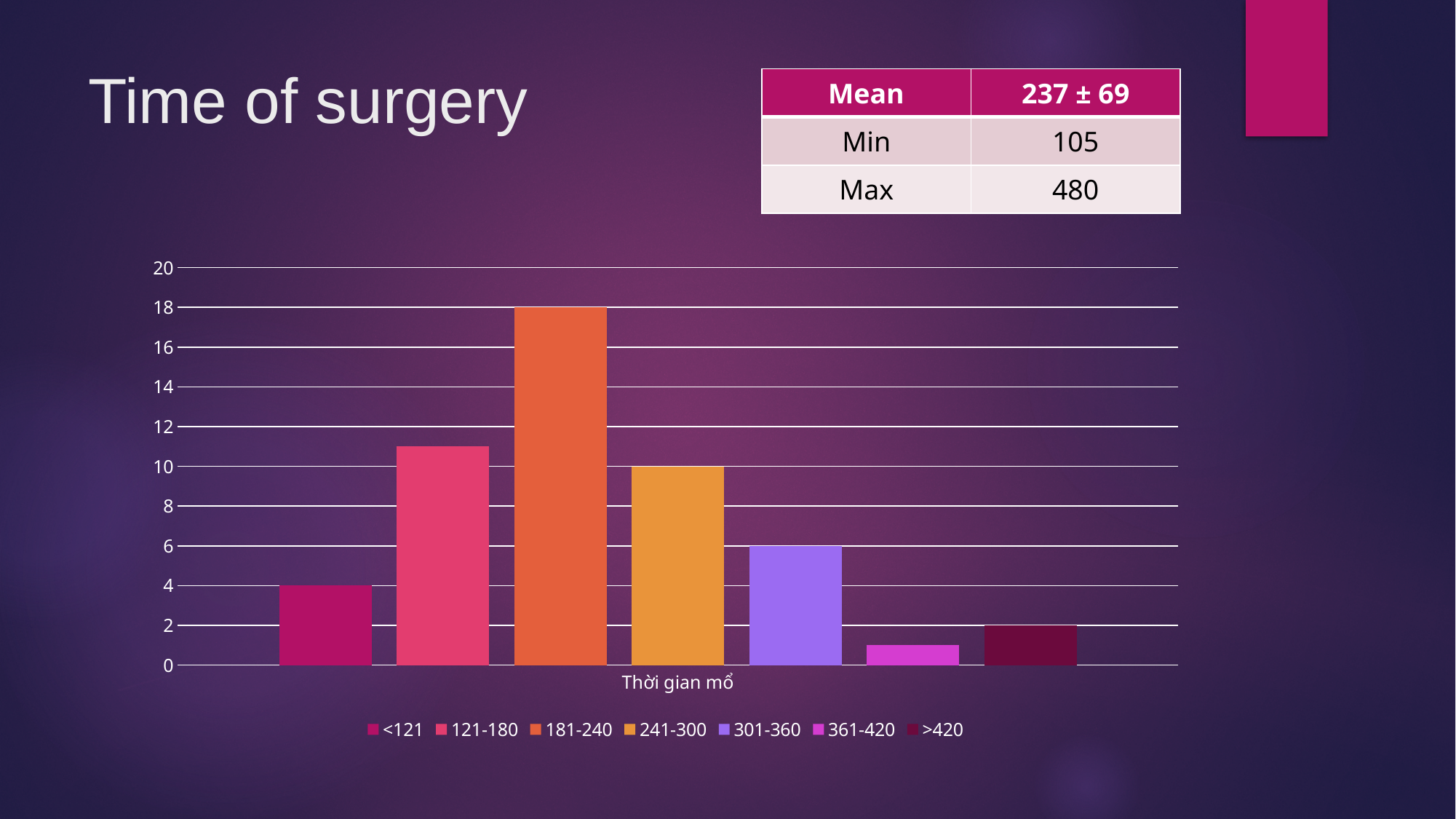
How many bars are plotted in the chart? 7 Which series has the highest value? 181-240 Which series has the lowest value? 361-420 What is the value for the 241-300 series? 10 What is the difference between the values for 181-240 and 241-300? 8 How many series does the legend list? 7 Which is larger, the value for 301-360 or the value for >420? 301-360 What is the value for the 181-240 series? 18 Is the value for the 121-180 series greater or less than 10? greater What is the value for the <121 series? 4 What is the value for the 301-360 series? 6 What type of chart is shown on the slide? bar chart